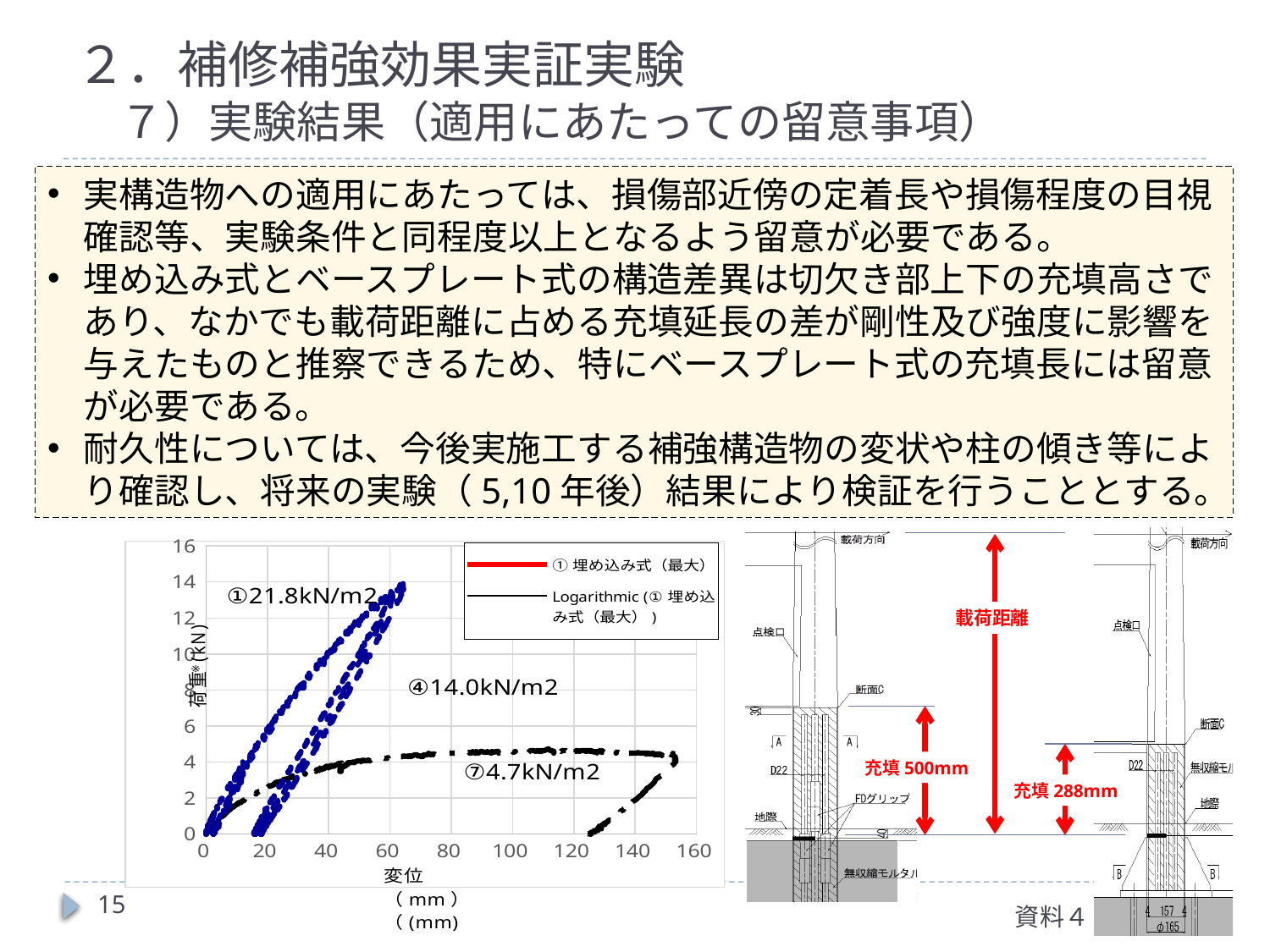
How many series does the legend of the chart list? 2 Which series reaches the higher load, the blue ① 埋め込み式（最大） series or the black dashed series? ① 埋め込み式（最大） Is the peak load reached by the blue ① 埋め込み式（最大） series greater or less than 12 kN? greater What kind of chart is shown at the bottom left of the slide? scatter chart Is the maximum displacement reached by the black dashed series greater or less than 140 mm? greater What value is annotated for ④ in the chart? 14.0kN/m2 What is the label on the vertical axis of the chart? 荷重* (kN) Is the maximum displacement reached by the blue series greater or less than 80 mm? less What value is annotated next to the curve labelled ① in the chart? 21.8kN/m2 What is the label on the horizontal axis of the chart? 変位 (mm) What value is annotated for ⑦ in the chart? 4.7kN/m2